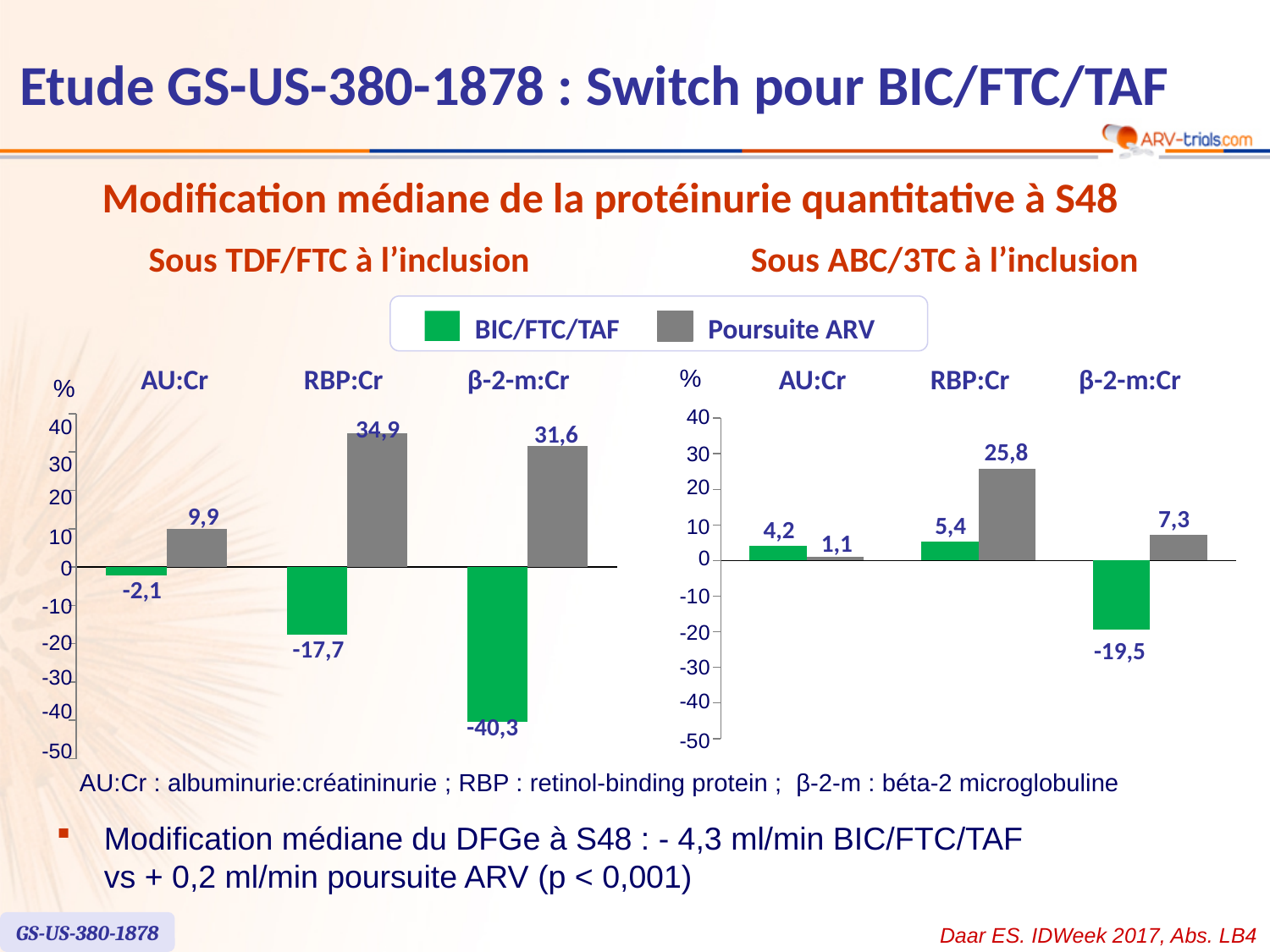
How many categories are shown on the x axis of the 'Sous ABC/3TC à l'inclusion' chart? 3 What kind of chart is the 'Sous TDF/FTC à l'inclusion' chart? Bar chart In the 'Sous TDF/FTC à l'inclusion' chart, which category has the lowest BIC/FTC/TAF value? β-2-m:Cr In the 'Sous ABC/3TC à l'inclusion' chart, what is the difference between the Poursuite ARV and BIC/FTC/TAF values for RBP:Cr? 20,4 In the 'Sous TDF/FTC à l'inclusion' chart, which category has the highest Poursuite ARV value? RBP:Cr In the 'Sous ABC/3TC à l'inclusion' chart, what is the value for Poursuite ARV for RBP:Cr? 25,8 How many series does the legend list? 2 In the 'Sous TDF/FTC à l'inclusion' chart, what is the value for Poursuite ARV for β-2-m:Cr? 31,6 In the 'Sous TDF/FTC à l'inclusion' chart, is the Poursuite ARV value for AU:Cr greater or less than 20? less In the 'Sous TDF/FTC à l'inclusion' chart, what is the value for BIC/FTC/TAF for RBP:Cr? -17,7 In the 'Sous ABC/3TC à l'inclusion' chart, what is the value for BIC/FTC/TAF for β-2-m:Cr? -19,5 In the 'Sous ABC/3TC à l'inclusion' chart, which is larger for AU:Cr, BIC/FTC/TAF or Poursuite ARV? BIC/FTC/TAF